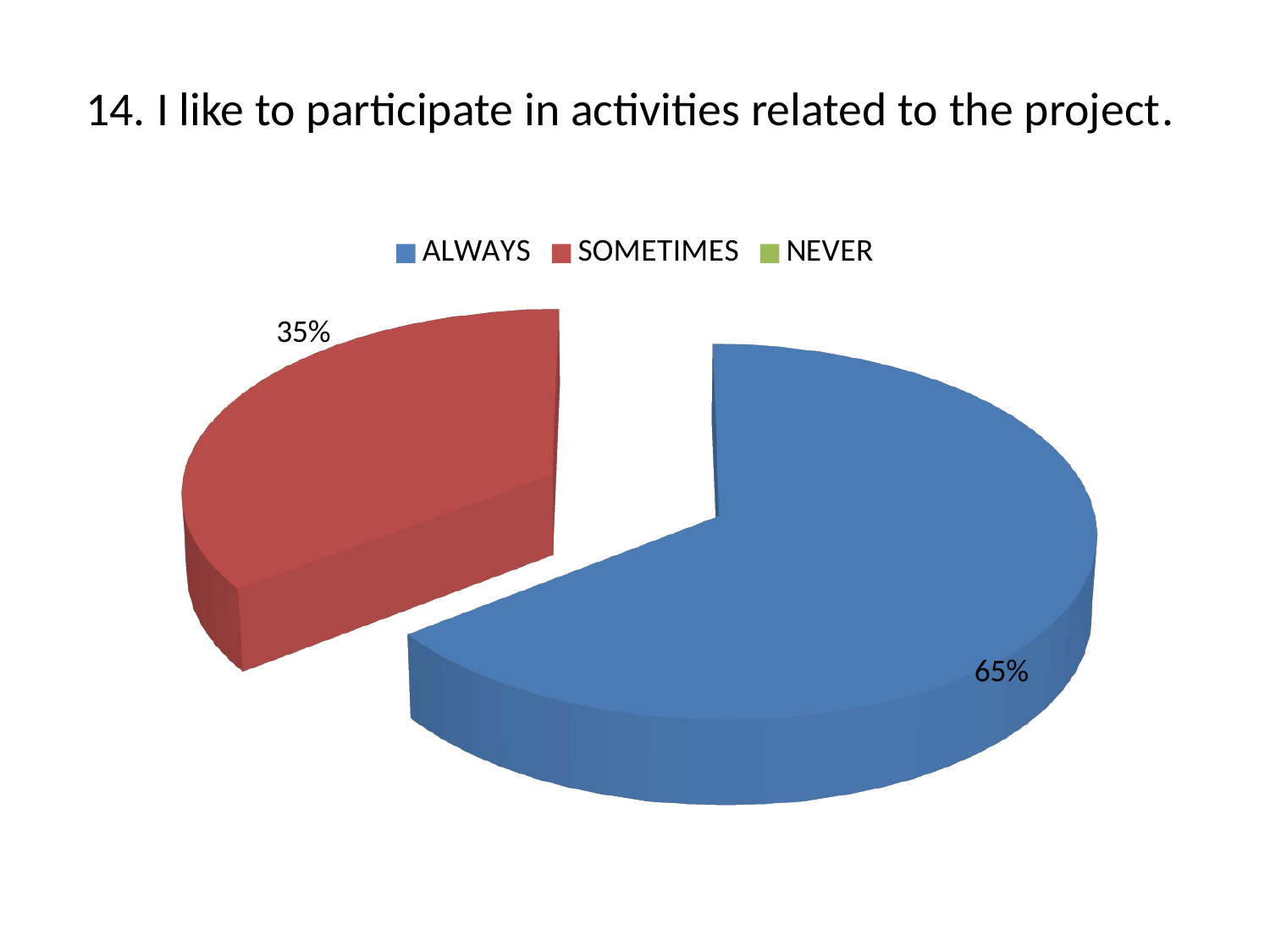
Which legend entry has no visible slice in the pie? NEVER How many entries does the legend list? 3 What share of the pie is labelled ALWAYS? 65% How many slices are visible in the pie? 2 What is the difference in percentage points between the ALWAYS and SOMETIMES slices? 30 What kind of chart is shown on the slide? pie chart What share of the pie is labelled SOMETIMES? 35% Is the share for ALWAYS greater or less than 50%? greater Which of ALWAYS or SOMETIMES has the larger share? ALWAYS Which category has the largest slice of the pie? ALWAYS What colour is the SOMETIMES slice? red